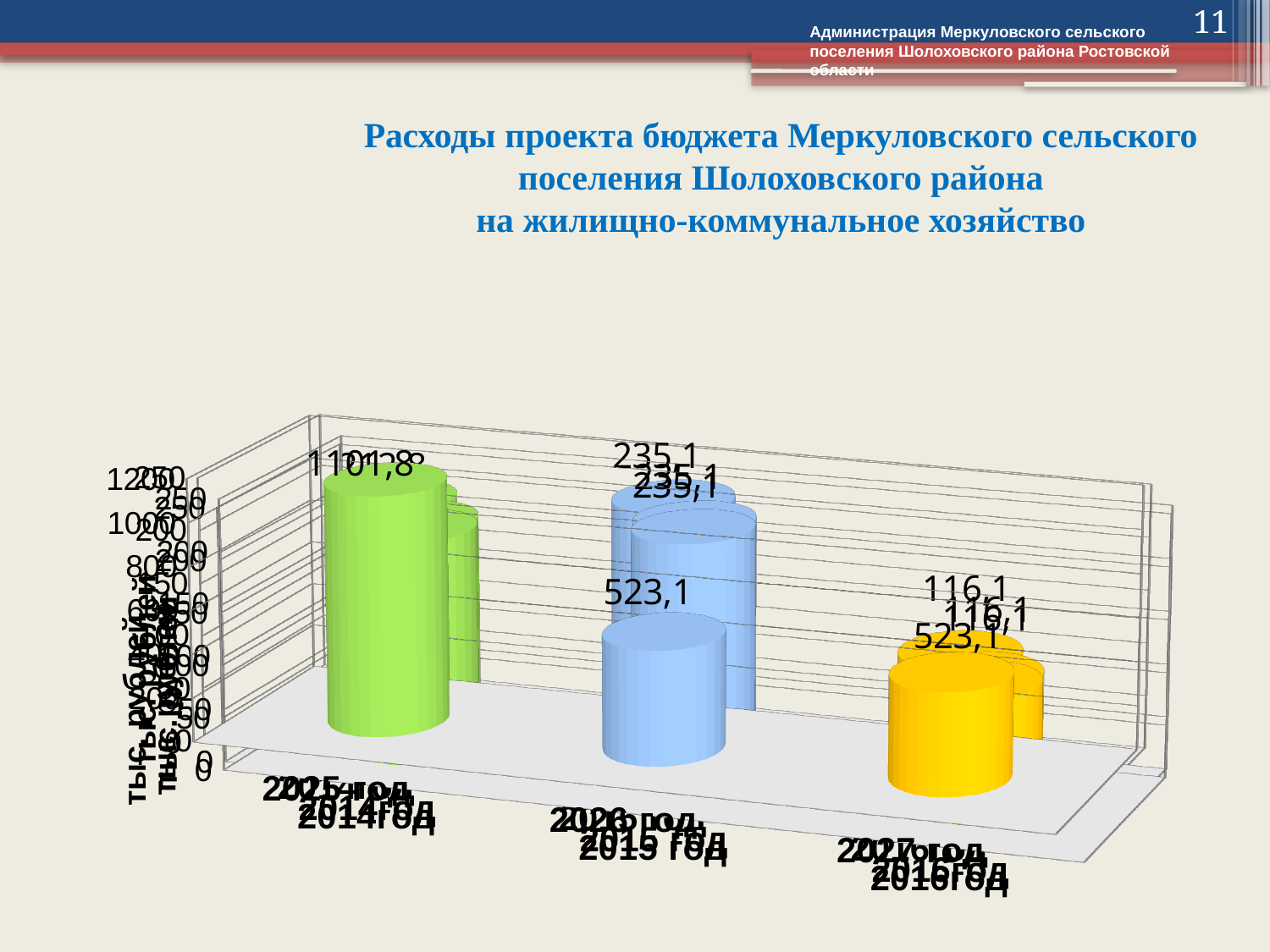
In the front-most chart, which bar is the tallest: the green, the blue or the yellow one? the green one What colours are the three bars in the front-most chart, from left to right? green, blue, yellow What is the title of the chart on the slide? Расходы проекта бюджета Меркуловского сельского поселения Шолоховского района на жилищно-коммунальное хозяйство How many bars are in the front-most chart on the slide? 3 What kind of chart is shown on the slide? bar chart